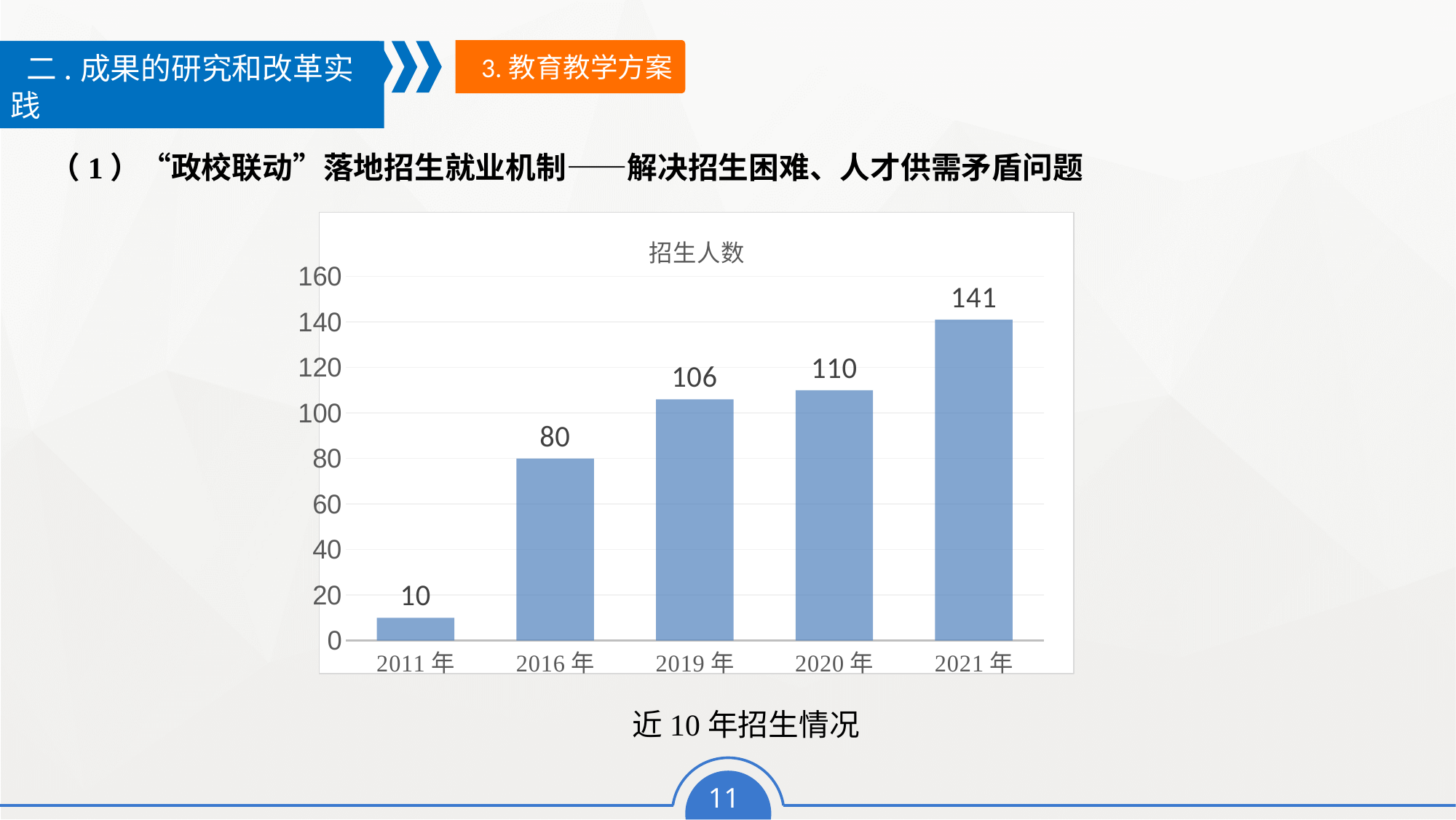
What is the value for 2011 年 in the 招生人数 chart? 10 What is the value for 2019 年 in the 招生人数 chart? 106 What is the difference between the values for 2021 年 and 2020 年 in the 招生人数 chart? 31 Which year has the lowest value in the 招生人数 chart? 2011 年 Is the value for 2020 年 in the 招生人数 chart greater or less than 100? greater Which year has the highest value in the 招生人数 chart? 2021 年 What kind of chart is the 招生人数 chart? bar chart How many years are shown on the x axis of the 招生人数 chart? 5 What is the value for 2021 年 in the 招生人数 chart? 141 What is the difference between the values for 2016 年 and 2011 年 in the 招生人数 chart? 70 Which is larger in the 招生人数 chart, the value for 2016 年 or the value for 2019 年? 2019 年 Do the values in the 招生人数 chart rise or fall from 2011 年 to 2021 年? rise